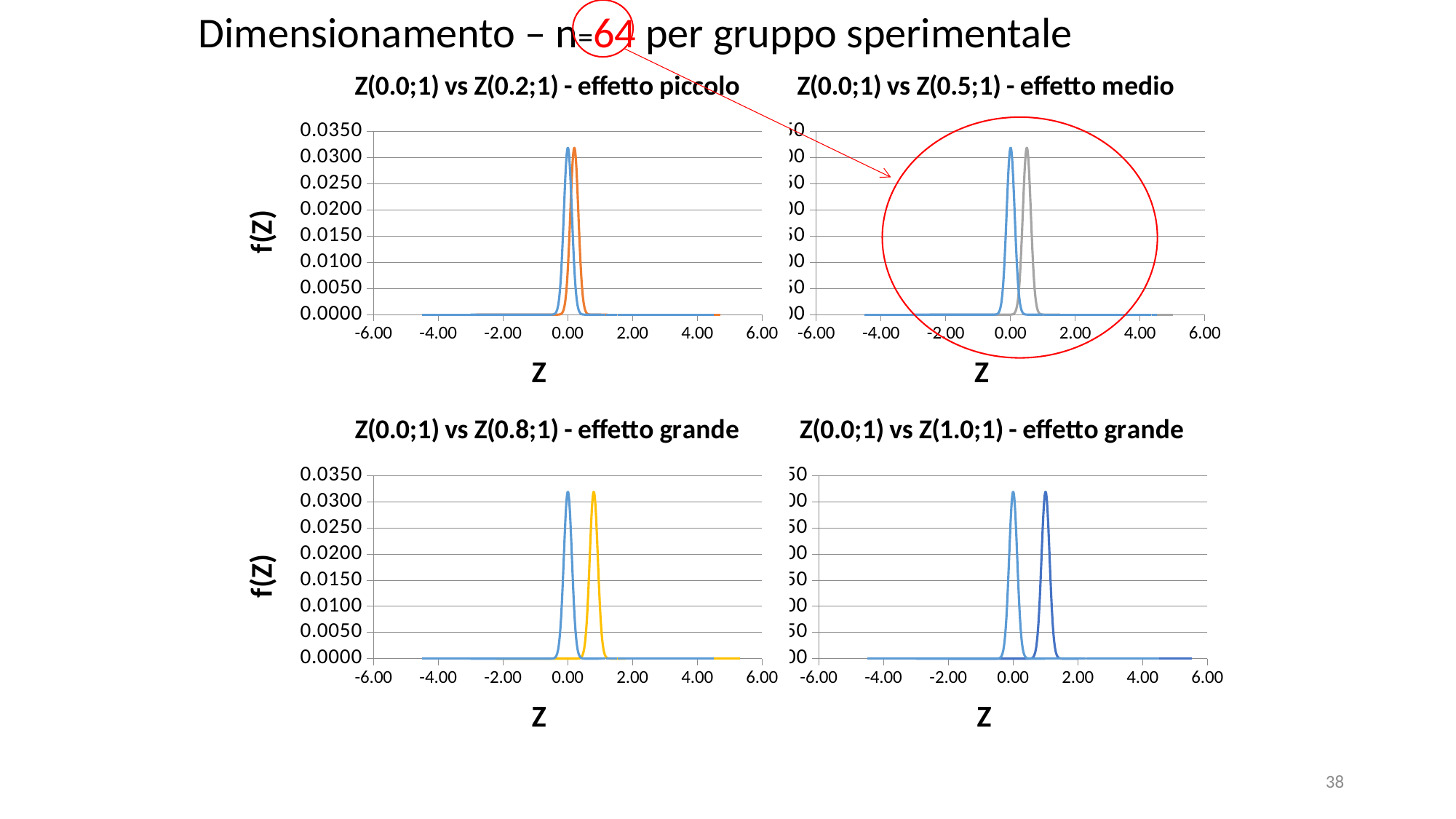
In the top-right chart "Z(0.0;1) vs Z(0.5;1) - effetto medio", which curve peaks further to the right on the Z axis, the blue one or the grey one? the grey one What is the highest tick value shown on the vertical axis of the top-left chart "Z(0.0;1) vs Z(0.2;1) - effetto piccolo"? 0.0350 What is the label of the vertical axis on the top-left chart? f(Z) What kind of chart is the top-left chart titled "Z(0.0;1) vs Z(0.2;1) - effetto piccolo"? line chart In the bottom-right chart "Z(0.0;1) vs Z(1.0;1) - effetto grande", is the peak value of the curves greater or less than 0.0300? greater In the bottom-left chart "Z(0.0;1) vs Z(0.8;1) - effetto grande", is the peak value of the yellow curve greater or less than 0.0350? less In the top-left chart "Z(0.0;1) vs Z(0.2;1) - effetto piccolo", how many curves are plotted? 2 In the top-left chart "Z(0.0;1) vs Z(0.2;1) - effetto piccolo", do the curve values rise or fall as Z moves from 0.00 toward 6.00? fall In the bottom-left chart "Z(0.0;1) vs Z(0.8;1) - effetto grande", which curve peaks further to the right on the Z axis, the blue one or the yellow one? the yellow one How many charts are shown on the slide? 4 What is the title of the bottom-left chart? Z(0.0;1) vs Z(0.8;1) - effetto grande What is the lowest tick value shown on the horizontal axis of the bottom-right chart "Z(0.0;1) vs Z(1.0;1) - effetto grande"? -6.00